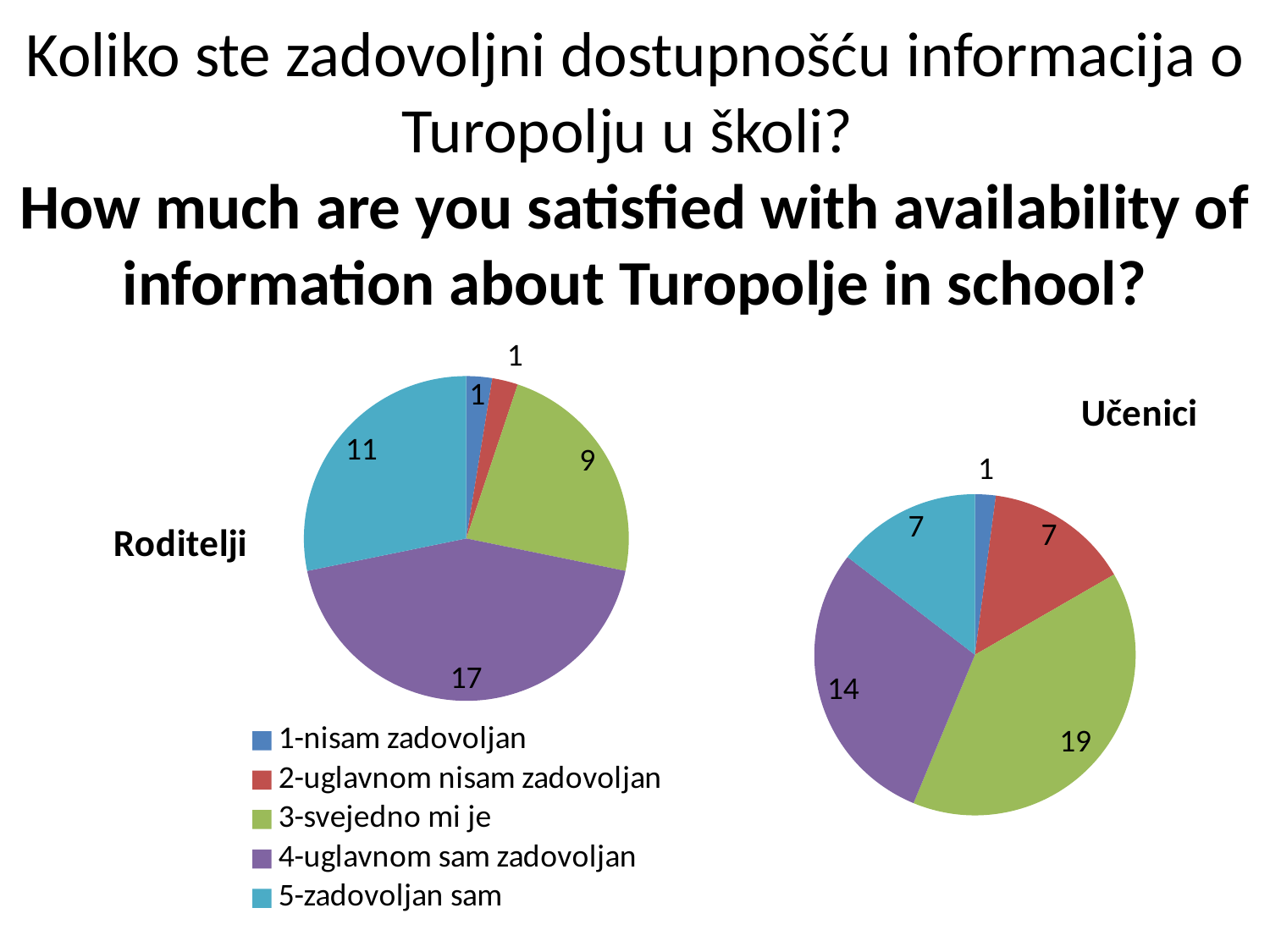
In the Roditelji chart, what is the value for 4-uglavnom sam zadovoljan? 17 How many categories does the legend list? 5 What type of chart is the Roditelji chart? pie chart In the Učenici chart, what is the value for 2-uglavnom nisam zadovoljan? 7 In the Učenici chart, which category has the smallest slice? 1-nisam zadovoljan In the Učenici chart, which is larger: the value for 4-uglavnom sam zadovoljan or the value for 5-zadovoljan sam? 4-uglavnom sam zadovoljan In the Učenici chart, what is the value for 3-svejedno mi je? 19 In the Učenici chart, which category has the largest slice? 3-svejedno mi je In the Roditelji chart, what is the value for 5-zadovoljan sam? 11 In the Učenici chart, what is the total of all slices? 48 In the Roditelji chart, what is the difference between the values for 4-uglavnom sam zadovoljan and 5-zadovoljan sam? 6 In the Roditelji chart, which category has the largest slice? 4-uglavnom sam zadovoljan